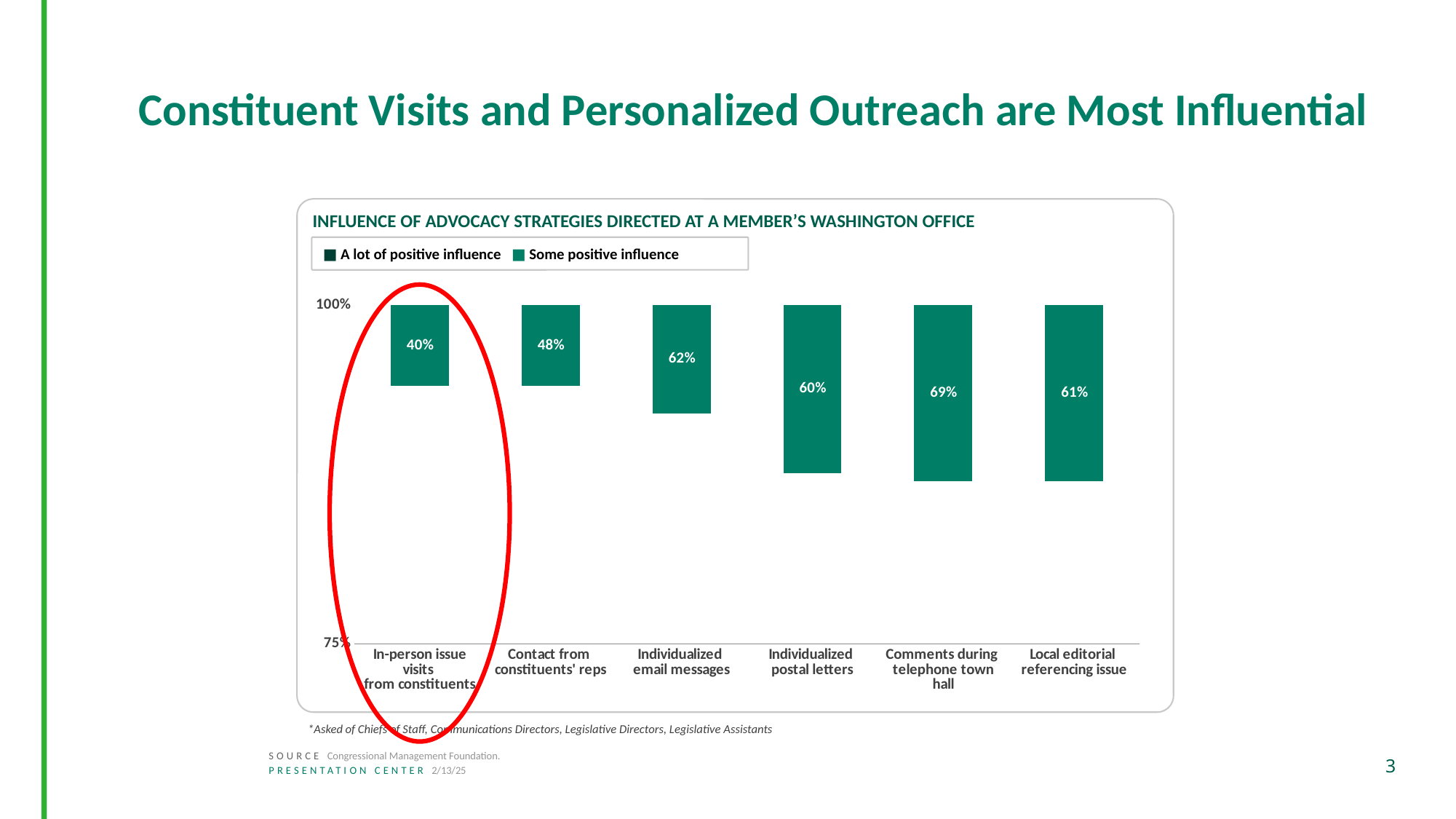
What is the title of the chart? Influence of Advocacy Strategies Directed at a Member's Washington Office Which category has the lowest labeled value? In-person issue visits from constituents What value is labeled on the bar for Individualized email messages? 62% What is the difference between the labeled values for Comments during telephone town hall and In-person issue visits from constituents? 29 percentage points Which category has the highest labeled value? Comments during telephone town hall Which has the larger labeled value, Individualized postal letters or Local editorial referencing issue? Local editorial referencing issue What kind of chart is shown on the slide? Bar chart What value is labeled on the bar for Comments during telephone town hall? 69% What value is labeled on the bar for Contact from constituents' reps? 48% What value is labeled on the bar for In-person issue visits from constituents? 40% How many categories are shown along the x axis of the chart? 6 How many series does the chart legend list? 2